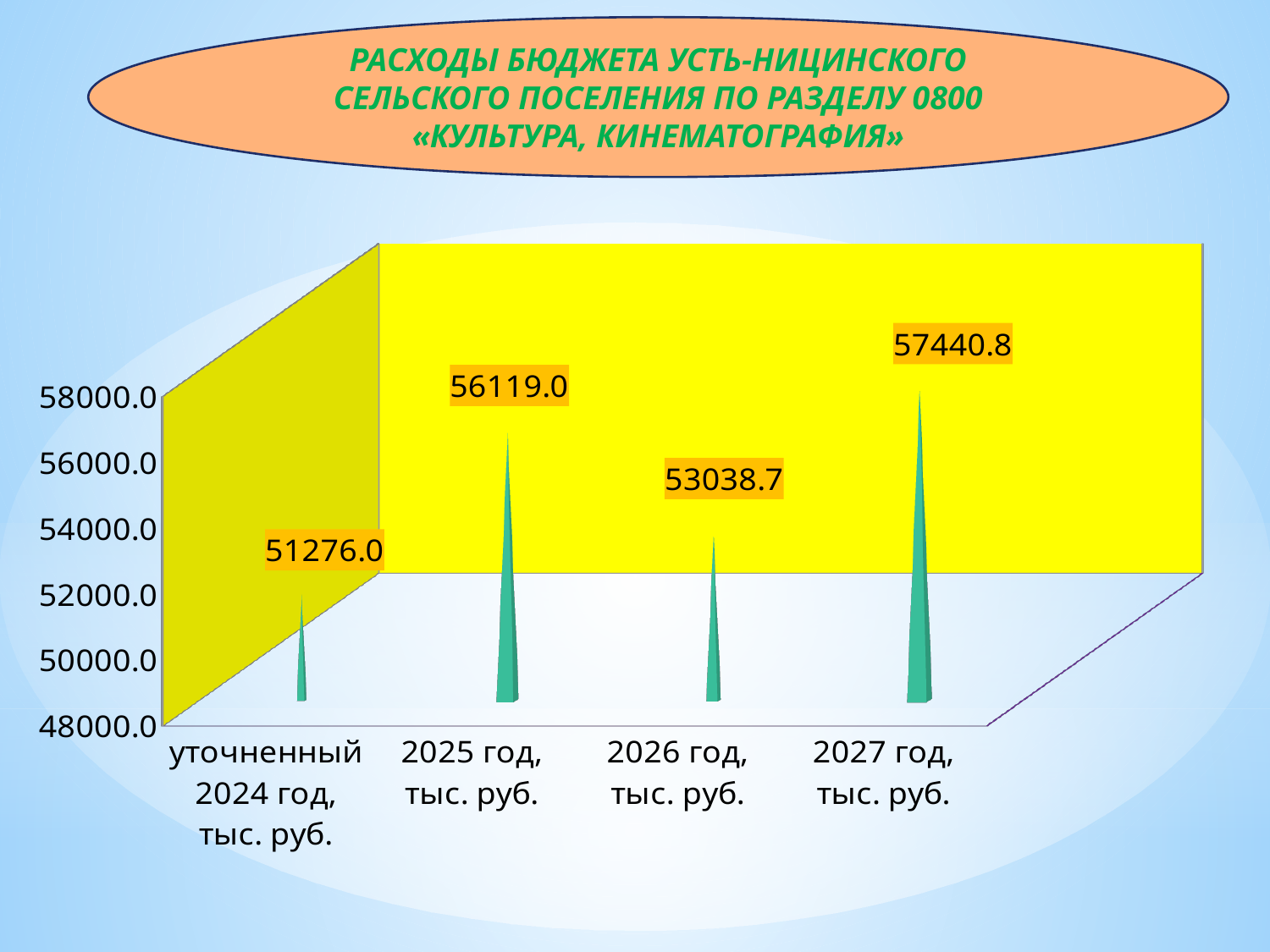
What is the value for 2026 год? 53038.7 What kind of chart is shown on the slide? bar chart What is the difference between the values for 2025 год and 2026 год? 3080.3 What is the value for 2025 год? 56119.0 How many categories are shown on the x axis? 4 Which year has the lowest value? уточненный 2024 год What is the difference between the values for 2027 год and уточненный 2024 год? 6164.8 What is the value for 2027 год? 57440.8 Which year has the highest value? 2027 год What is the value for уточненный 2024 год? 51276.0 Which is larger, the value for 2025 год or the value for 2026 год? 2025 год Does the value rise or fall from 2025 год to 2026 год? fall